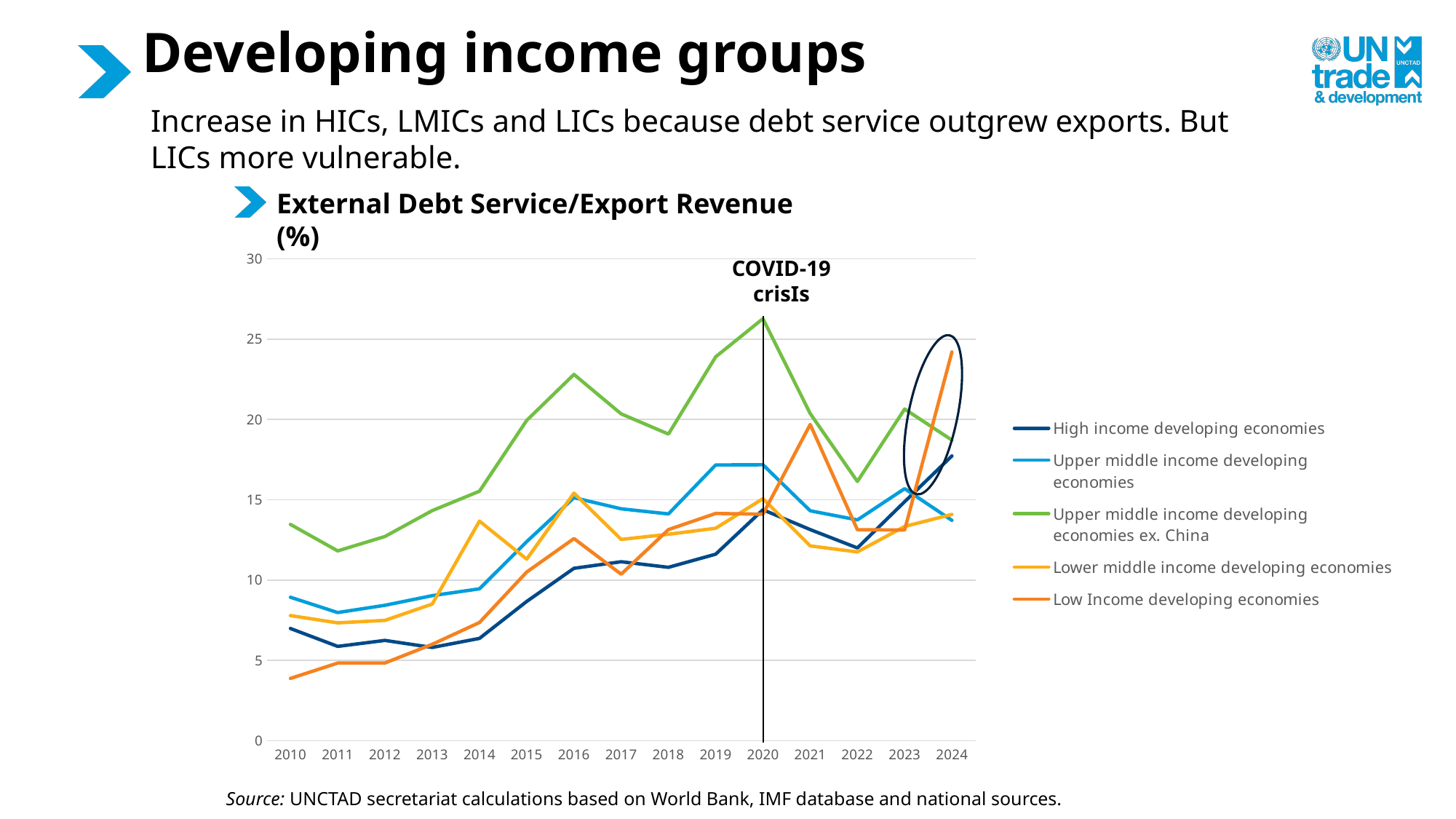
Which is larger for Upper middle income developing economies ex. China: the value in 2020 or the value in 2022? 2020 How many series does the legend list? 5 Which series has the lowest value in 2010? Low Income developing economies Which series has the highest value in 2024? Low Income developing economies Is the value for Low Income developing economies in 2024 greater or less than 20? greater Is the value for High income developing economies in 2010 greater or less than 10? less Is the value for Upper middle income developing economies ex. China in 2020 greater or less than 25? greater Does the value for High income developing economies rise or fall overall from 2010 to 2024? Rise What event is marked by the vertical line at 2020? COVID-19 crisis How many years are shown on the x axis? 15 Which series has the highest value in 2020? Upper middle income developing economies ex. China What kind of chart is shown on the slide? Line chart